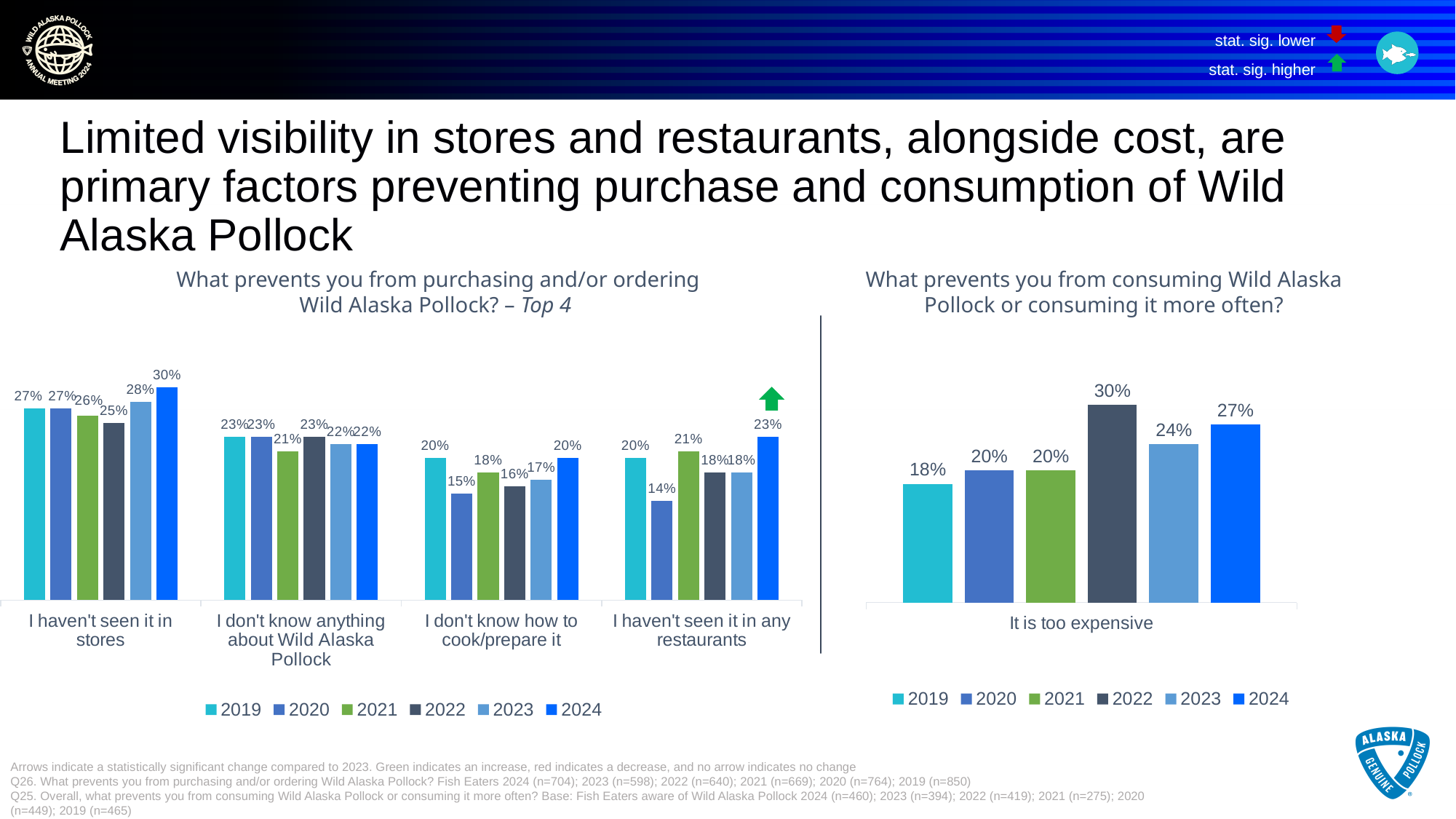
In the left chart (What prevents you from purchasing and/or ordering Wild Alaska Pollock?), what is the 2024 value for "I haven't seen it in stores"? 30% In the left chart, what is the 2020 value for "I haven't seen it in any restaurants"? 14% In the right chart, what is the difference between the 2022 and 2024 values for "It is too expensive"? 3% In the left chart, what is the 2021 value for "I don't know anything about Wild Alaska Pollock"? 21% In the left chart, what is the difference between the 2024 and 2023 values for "I haven't seen it in any restaurants"? 5% How many series does the legend of the right chart list? 6 What type of chart is the right chart (It is too expensive)? Bar chart In the right chart (What prevents you from consuming Wild Alaska Pollock or consuming it more often?), which year has the highest value for "It is too expensive"? 2022 In the left chart, which is larger for "I don't know how to cook/prepare it": the 2019 value or the 2020 value? 2019 In the left chart, which category has a green arrow indicating a statistically significant increase in 2024? I haven't seen it in any restaurants How many categories are shown on the x axis of the left chart? 4 In the right chart, which year has the lowest value for "It is too expensive"? 2019